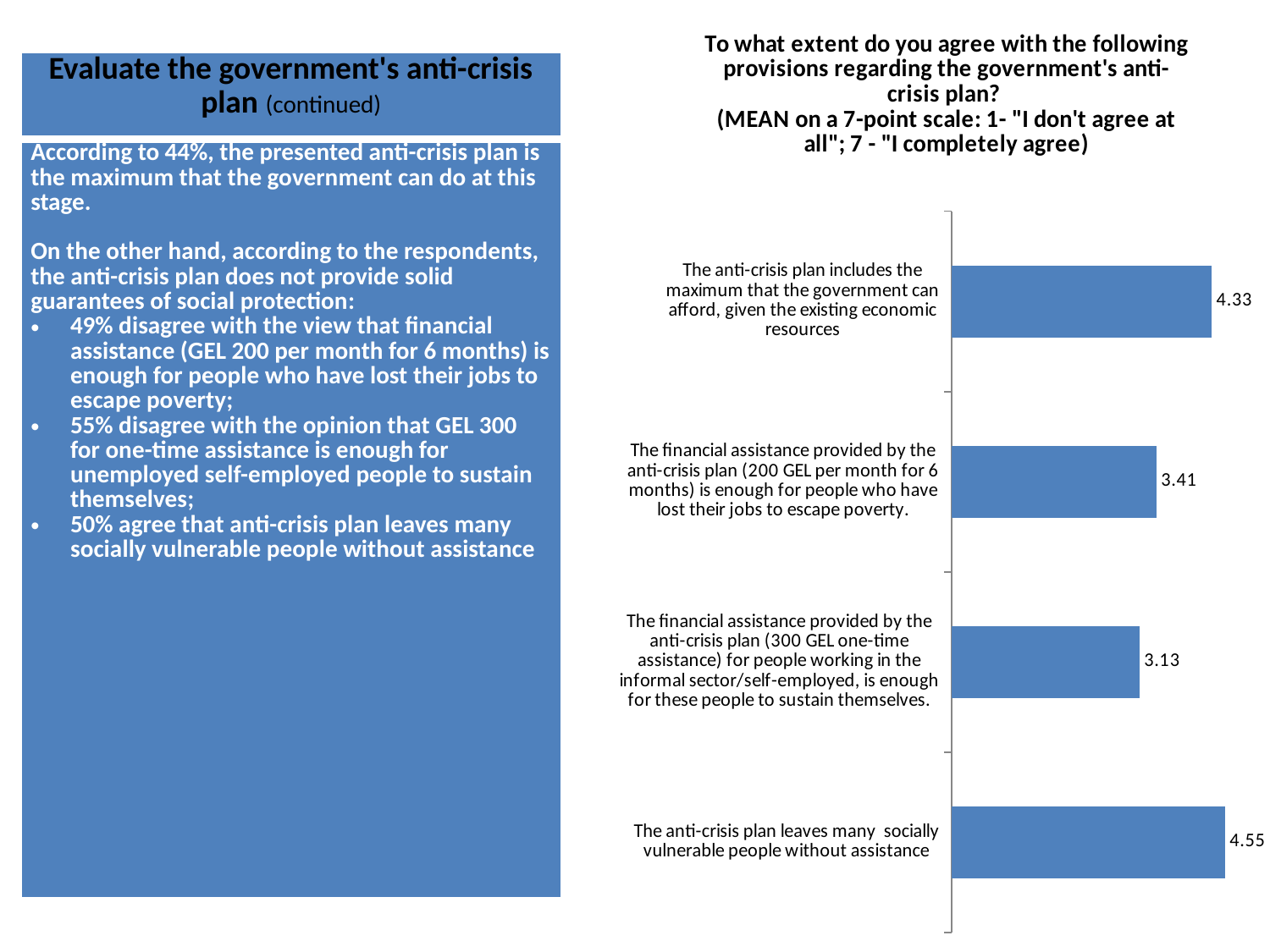
Which has a higher mean score: the statement about 200 GEL per month for 6 months or the statement about 300 GEL one-time assistance? The statement about 200 GEL per month for 6 months Which statement has the lowest mean score? The financial assistance provided by the anti-crisis plan (300 GEL one-time assistance) for people working in the informal sector/self-employed, is enough for these people to sustain themselves. Which statement has the highest mean score? The anti-crisis plan leaves many socially vulnerable people without assistance What is the mean score for the statement about 300 GEL one-time assistance being enough for self-employed people to sustain themselves? 3.13 What is the mean score for "The anti-crisis plan leaves many socially vulnerable people without assistance"? 4.55 What scale are the mean scores in the chart based on? A 7-point scale What type of chart is shown on the slide? Bar chart What is the mean score for "The anti-crisis plan includes the maximum that the government can afford, given the existing economic resources"? 4.33 What is the difference between the mean score for the statement that the plan leaves many socially vulnerable people without assistance and the statement that the plan includes the maximum the government can afford? 0.22 How many statements are plotted in the chart? 4 What is the difference between the mean scores for the 200 GEL per month statement and the 300 GEL one-time assistance statement? 0.28 What is the mean score for "The financial assistance provided by the anti-crisis plan (200 GEL per month for 6 months) is enough for people who have lost their jobs to escape poverty"? 3.41